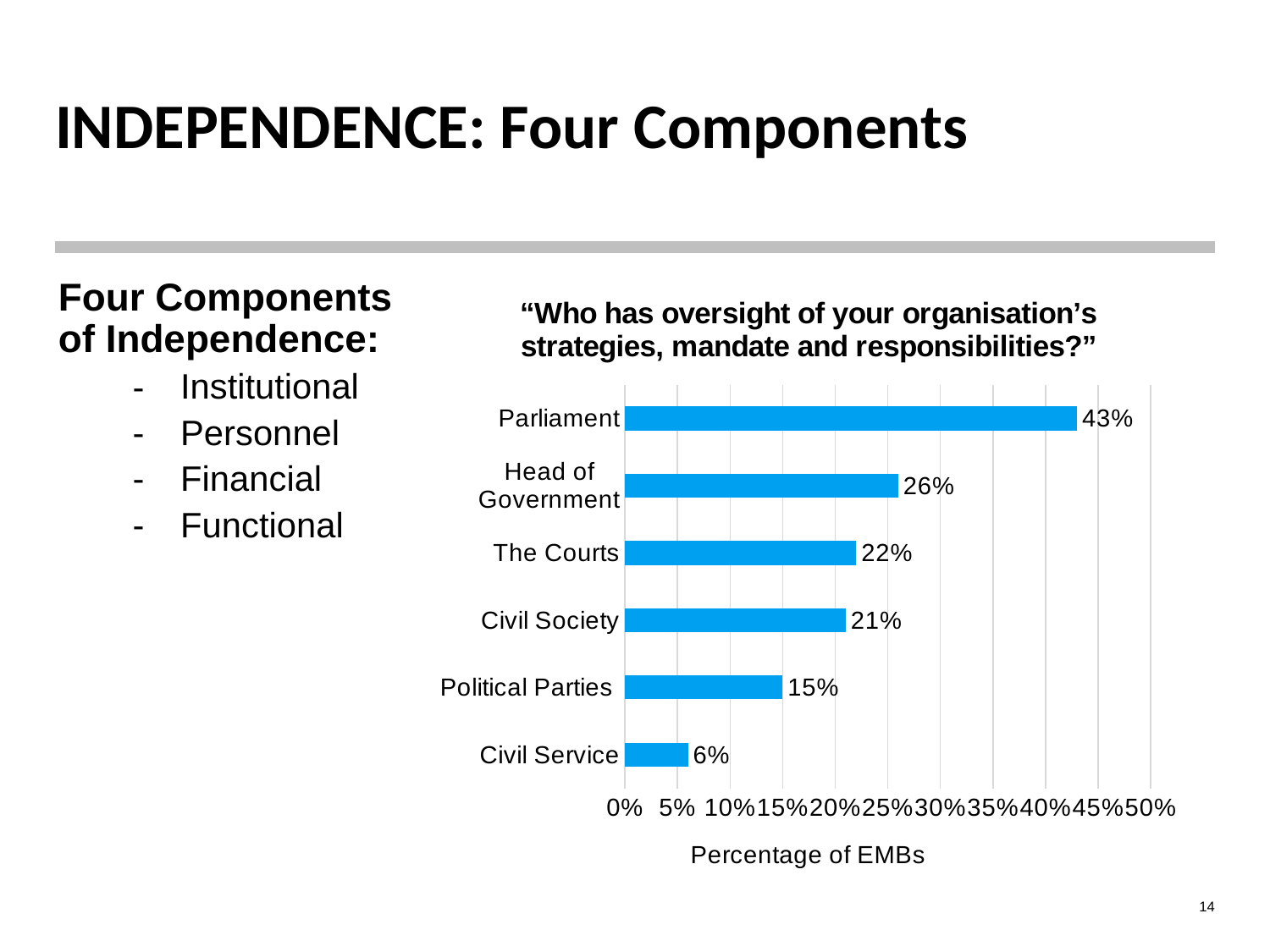
Which category has the highest percentage of EMBs? Parliament What is the difference between the values for Political Parties and Civil Service? 9% What percentage is shown for Civil Service? 6% How many categories are shown in the chart? 6 What is the label of the horizontal axis of the chart? Percentage of EMBs What kind of chart is shown on the slide? Bar chart Which is larger, the value for The Courts or the value for Political Parties? The Courts What is the difference between the values for Parliament and Head of Government? 17% Which category has the lowest percentage of EMBs? Civil Service What percentage of EMBs report that Parliament has oversight of their strategies, mandate and responsibilities? 43% Is the value for Civil Society greater or less than 25%? less What is the value shown for Head of Government? 26%